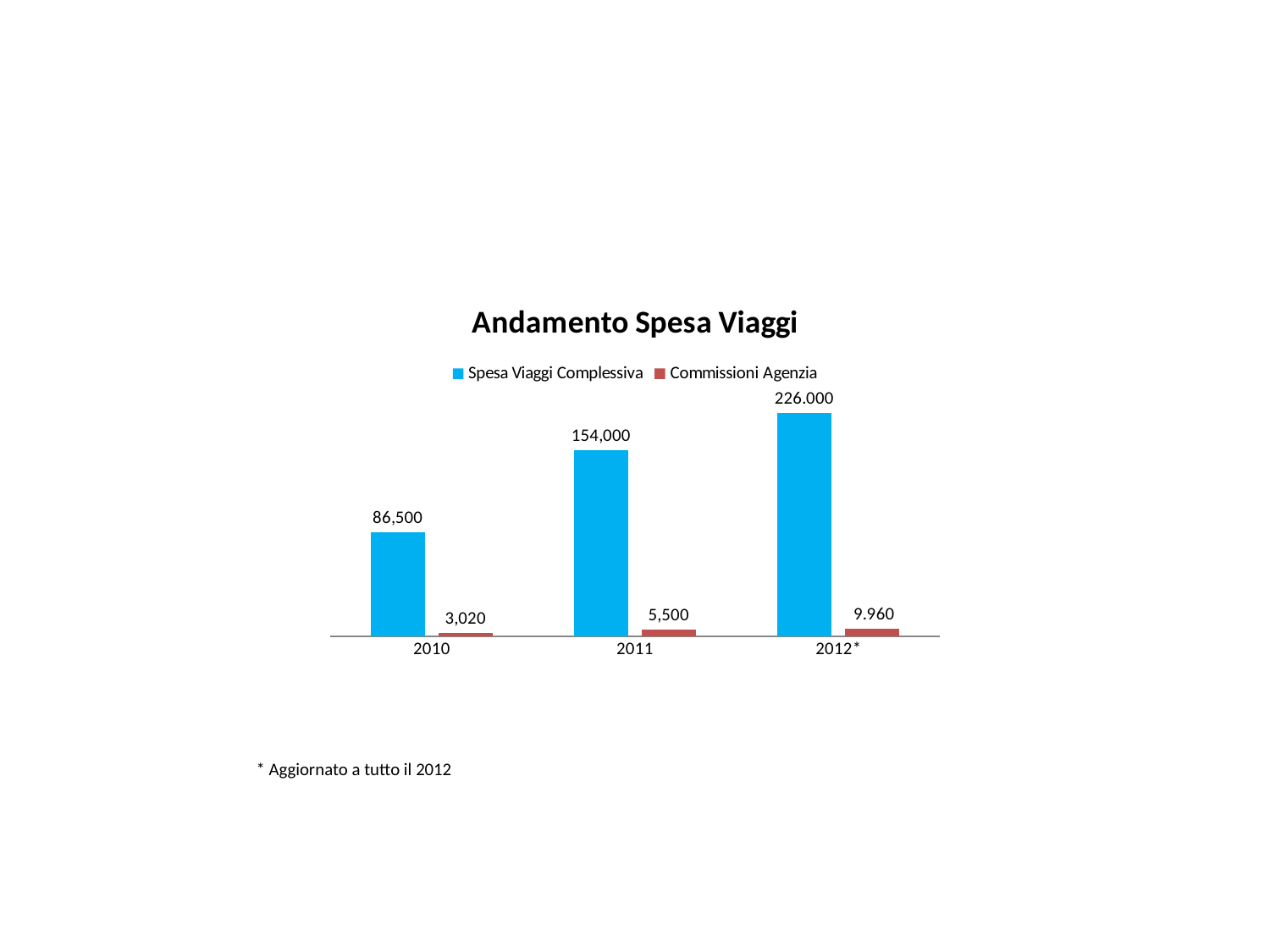
What is the difference between Spesa Viaggi Complessiva in 2011 and in 2010? 67,500 What is the value of Commissioni Agenzia for 2011? 5,500 What is the value of Spesa Viaggi Complessiva for 2012*? 226.000 How many years are shown on the x axis? 3 Does Spesa Viaggi Complessiva rise or fall from 2010 to 2012*? rise What is the value of Commissioni Agenzia for 2012*? 9.960 Which year has the highest Spesa Viaggi Complessiva? 2012* What is the value of Spesa Viaggi Complessiva for 2010? 86,500 How many series does the legend list? 2 Which is larger: Spesa Viaggi Complessiva in 2011 or in 2012*? 2012* What is the difference between Commissioni Agenzia in 2011 and in 2010? 2,480 Which year has the lowest Commissioni Agenzia? 2010